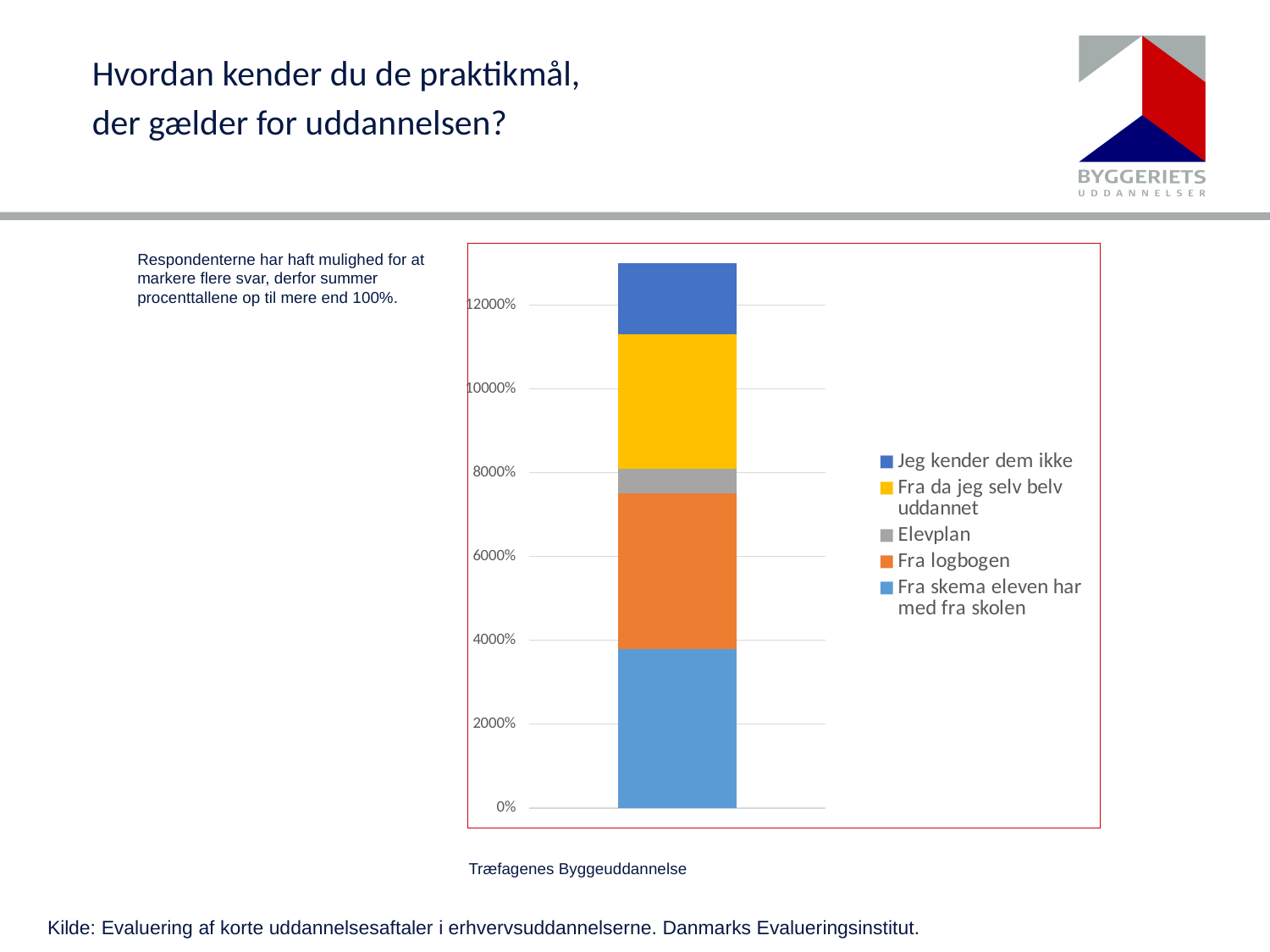
How many bars are plotted in the chart? 1 Is the value for "Fra skema eleven har med fra skolen" greater or less than 2000%? greater Which segment is larger: "Fra skema eleven har med fra skolen" or "Elevplan"? Fra skema eleven har med fra skolen What kind of chart is shown on the slide? stacked bar chart What colour represents "Elevplan" in the legend? grey Is the total height of the stacked bar greater or less than 12000%? greater Is the value for "Elevplan" greater or less than 2000%? less Which series is at the bottom of the stacked bar? Fra skema eleven har med fra skolen Which segment is larger: "Fra da jeg selv belv uddannet" or "Jeg kender dem ikke"? Fra da jeg selv belv uddannet Which series forms the smallest segment of the stacked bar? Elevplan How many series does the chart's legend list? 5 What is the highest value shown on the vertical axis? 12000%